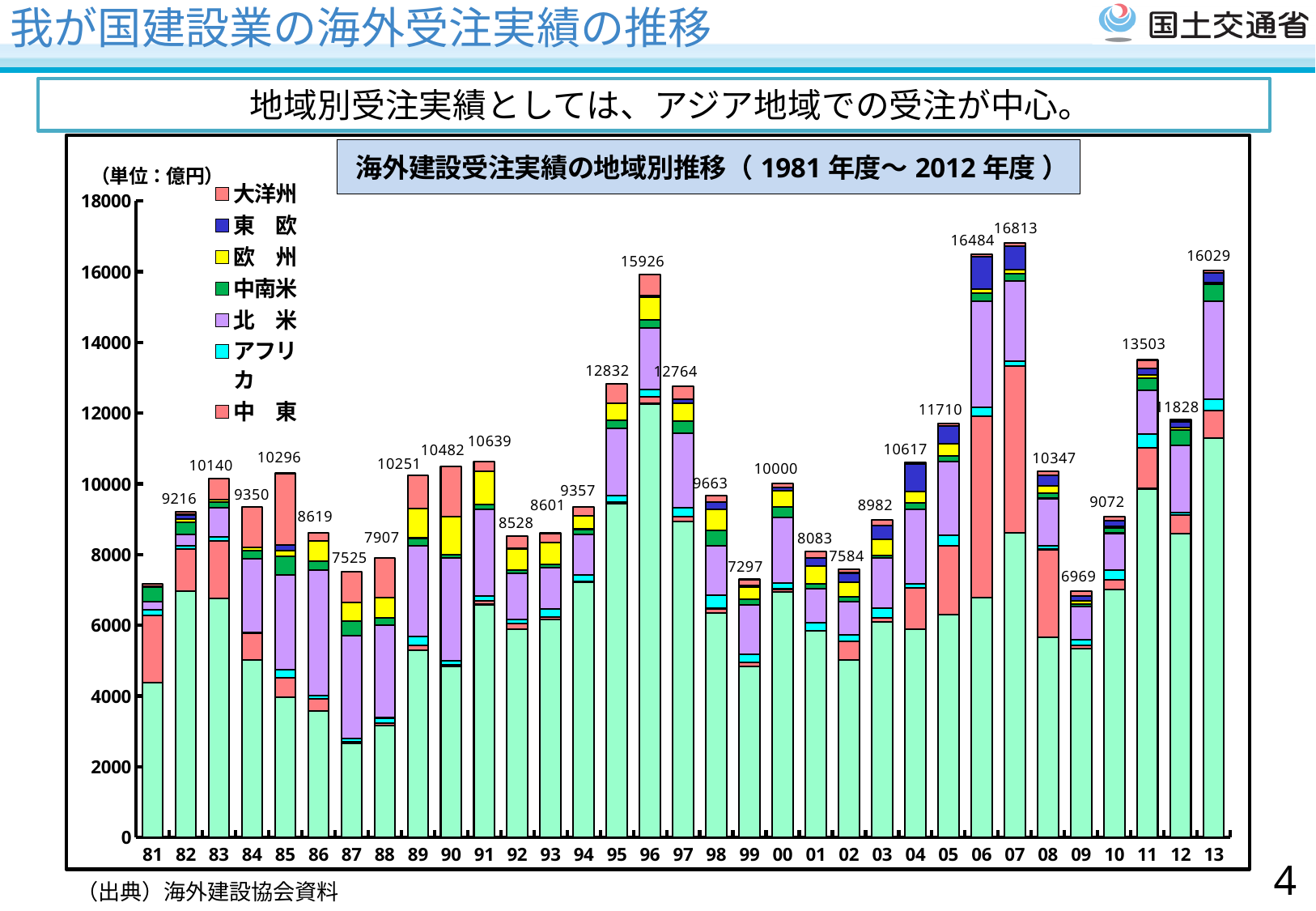
What is the difference between the labelled totals for fiscal years 13 and 12? 4201 Do the labelled totals rise or fall from fiscal year 07 to fiscal year 09? fall What is the total value labelled for fiscal year 13? 16029 Which is larger, the labelled total for fiscal year 95 or for fiscal year 97? 95 (12832) How many series does the legend list? 7 What is the total value labelled for fiscal year 96? 15926 Which fiscal year has the lowest labelled total? 09 (6969) What is the difference between the labelled totals for fiscal years 07 and 06? 329 What kind of chart is shown on the slide? Stacked bar chart Which fiscal year has the highest labelled total? 07 (16813) Is the total for fiscal year 81 greater or less than 6000? greater What is the total value labelled for fiscal year 09? 6969